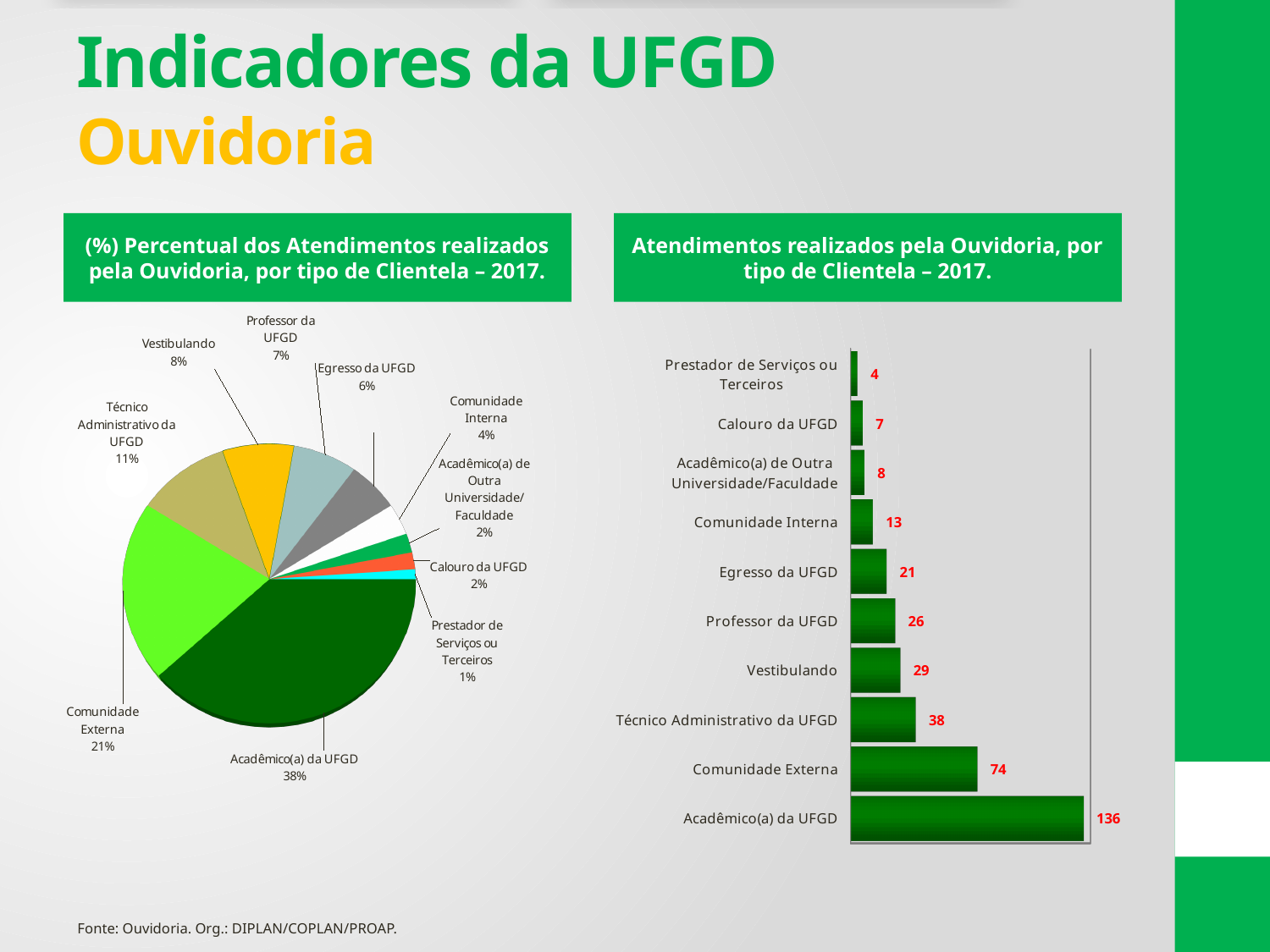
In the bar chart on the right, what is the value for Vestibulando? 29 In the pie chart on the left, which category has the smallest slice? Prestador de Serviços ou Terceiros In the bar chart on the right, which is larger: the value for Egresso da UFGD or the value for Professor da UFGD? Professor da UFGD In the pie chart on the left, what percentage is shown for Técnico Administrativo da UFGD? 11% How many categories are shown in the bar chart on the right? 10 In the pie chart on the left, what share does Acadêmico(a) da UFGD have? 38% In the bar chart on the right, what is the difference between the values for Acadêmico(a) da UFGD and Comunidade Externa? 62 In the bar chart on the right, which category has the lowest value? Prestador de Serviços ou Terceiros In the bar chart on the right, which category has the highest value? Acadêmico(a) da UFGD What kind of chart is the chart on the right? Bar chart In the bar chart on the right, what is the value for Comunidade Externa? 74 What kind of chart is the chart on the left? Pie chart